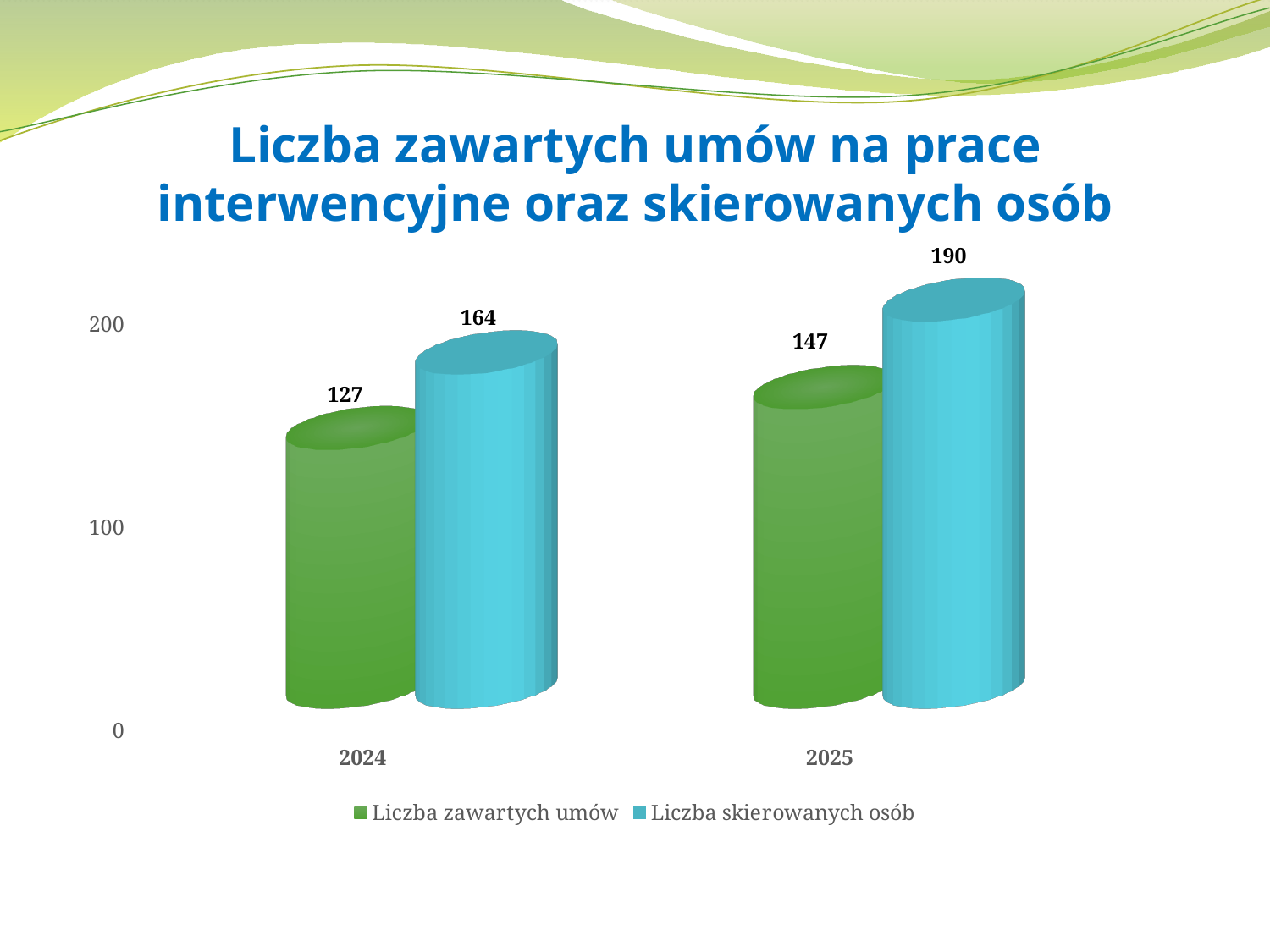
What is the difference between Liczba skierowanych osób and Liczba zawartych umów in 2025? 43 Which year has the lowest value for Liczba zawartych umów? 2024 What is the value of Liczba zawartych umów for 2025? 147 By how much did Liczba zawartych umów increase from 2024 to 2025? 20 Which year has the highest value for Liczba skierowanych osób? 2025 What is the value of Liczba zawartych umów for 2024? 127 Which is larger in 2024: Liczba zawartych umów or Liczba skierowanych osób? Liczba skierowanych osób How many years are shown on the x axis? 2 How many series does the legend list? 2 What is the value of Liczba skierowanych osób for 2025? 190 What kind of chart is shown on the slide? Bar chart What is the value of Liczba skierowanych osób for 2024? 164